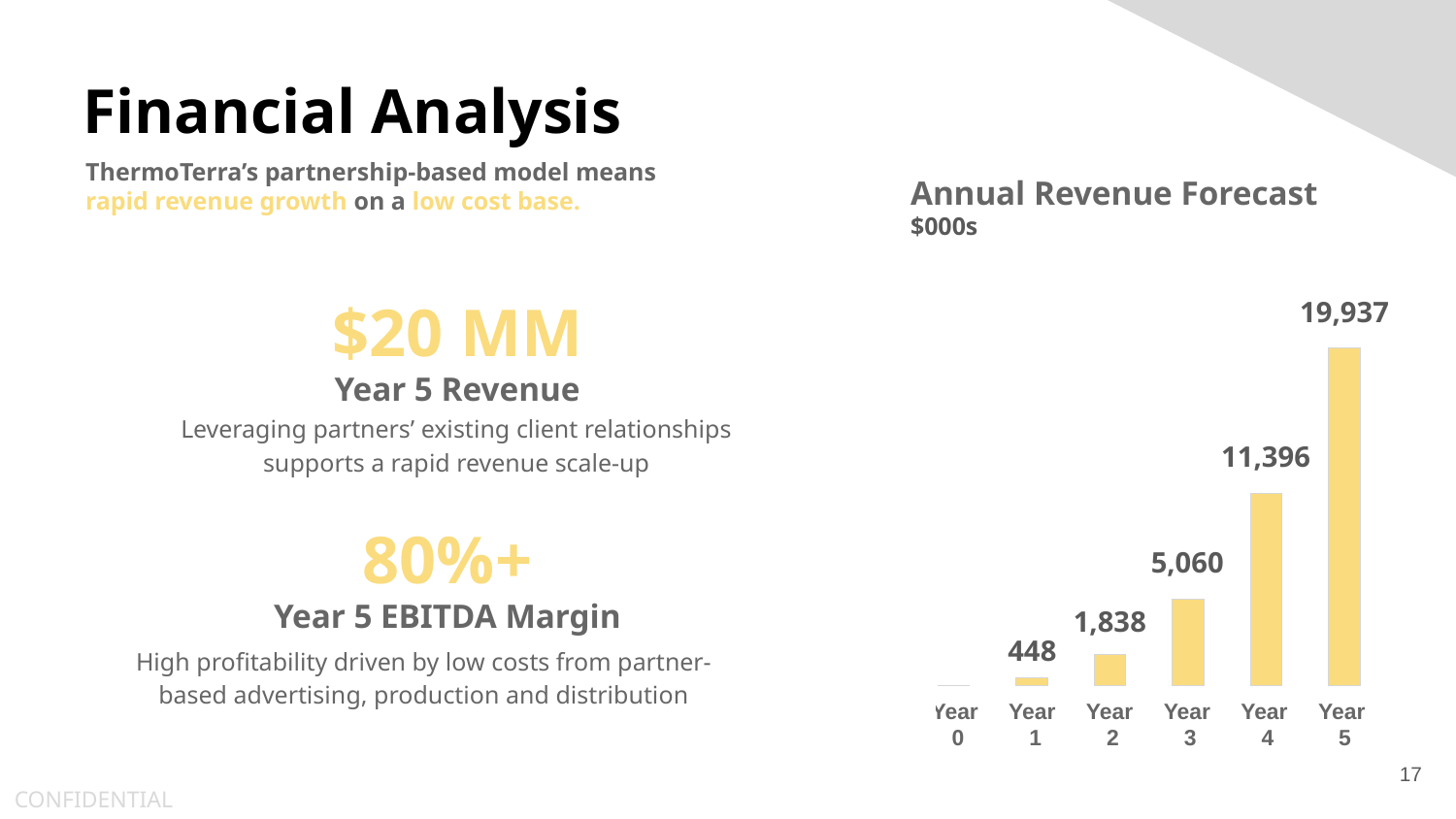
In the Annual Revenue Forecast chart, which is larger, the value for Year 3 or the value for Year 2? Year 3 What kind of chart is the Annual Revenue Forecast? Bar chart Do the values in the Annual Revenue Forecast chart rise or fall from Year 0 to Year 5? Rise Which year has the highest value in the Annual Revenue Forecast chart? Year 5 What is the difference between the Year 5 and Year 4 values in the Annual Revenue Forecast chart? 8,541 What is the value for Year 1 in the Annual Revenue Forecast chart? 448 What is the value for Year 5 in the Annual Revenue Forecast chart? 19,937 What is the value for Year 4 in the Annual Revenue Forecast chart? 11,396 How many years are shown on the x axis of the Annual Revenue Forecast chart? 6 Which year has the lowest value in the Annual Revenue Forecast chart? Year 0 What is the value for Year 3 in the Annual Revenue Forecast chart? 5,060 What is the difference between the Year 2 and Year 1 values in the Annual Revenue Forecast chart? 1,390